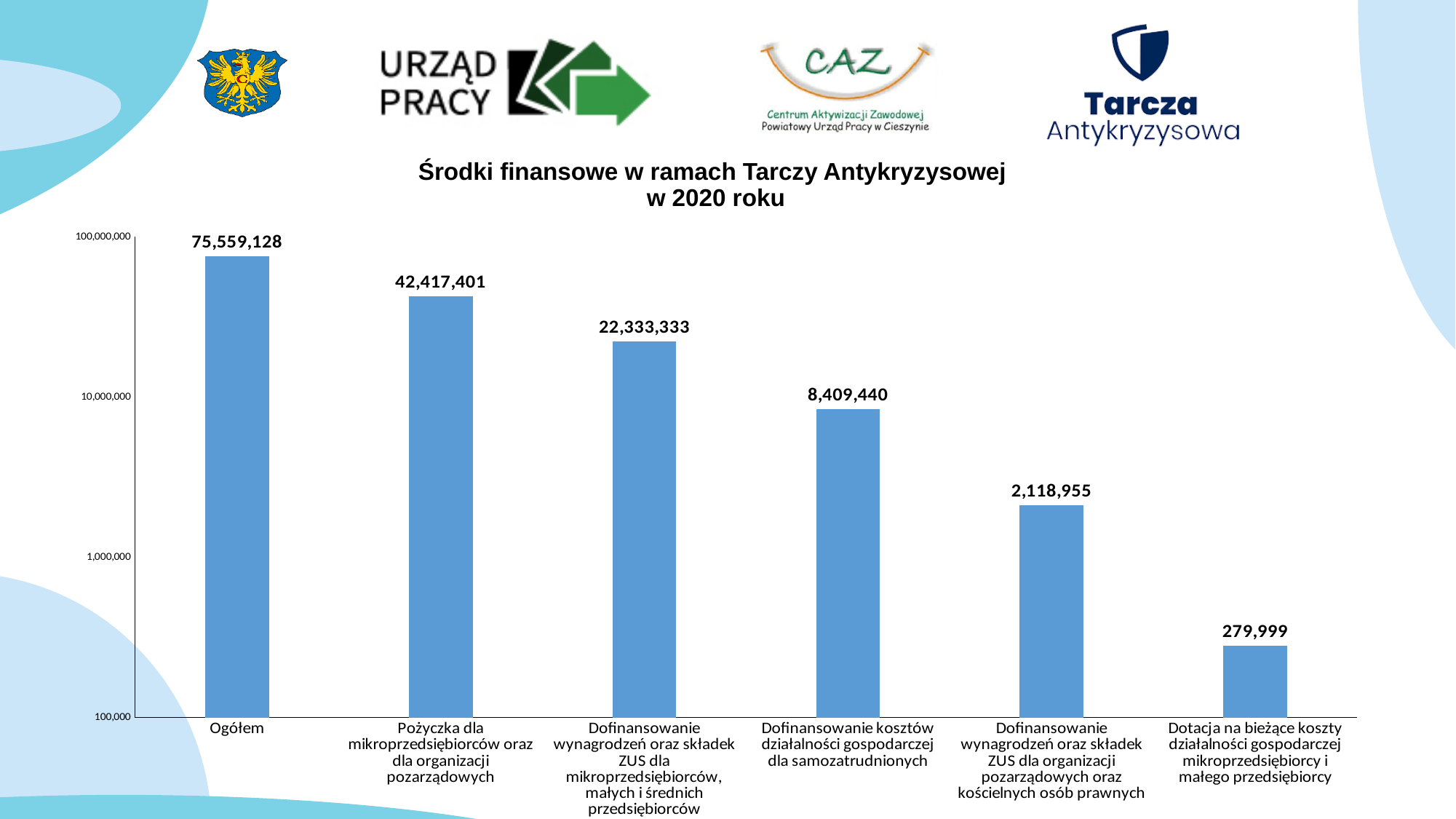
How many categories are shown on the chart? 6 What is the value for Pożyczka dla mikroprzedsiębiorców oraz dla organizacji pozarządowych? 42,417,401 What is the title of the chart? Środki finansowe w ramach Tarczy Antykryzysowej w 2020 roku Which is larger: the value for Dofinansowanie kosztów działalności gospodarczej dla samozatrudnionych or the value for Dofinansowanie wynagrodzeń oraz składek ZUS dla organizacji pozarządowych oraz kościelnych osób prawnych? Dofinansowanie kosztów działalności gospodarczej dla samozatrudnionych Which category has the lowest value? Dotacja na bieżące koszty działalności gospodarczej mikroprzedsiębiorcy i małego przedsiębiorcy What kind of chart is shown on the slide? bar chart What is the value for Dotacja na bieżące koszty działalności gospodarczej mikroprzedsiębiorcy i małego przedsiębiorcy? 279,999 What is the value for Dofinansowanie kosztów działalności gospodarczej dla samozatrudnionych? 8,409,440 Which category has the highest value? Ogółem What is the value for Ogółem? 75,559,128 What is the difference between the value for Pożyczka dla mikroprzedsiębiorców oraz dla organizacji pozarządowych and the value for Dofinansowanie wynagrodzeń oraz składek ZUS dla mikroprzedsiębiorców, małych i średnich przedsiębiorców? 20,084,068 Is the value for Dotacja na bieżące koszty działalności gospodarczej mikroprzedsiębiorcy i małego przedsiębiorcy greater or less than 1,000,000? less